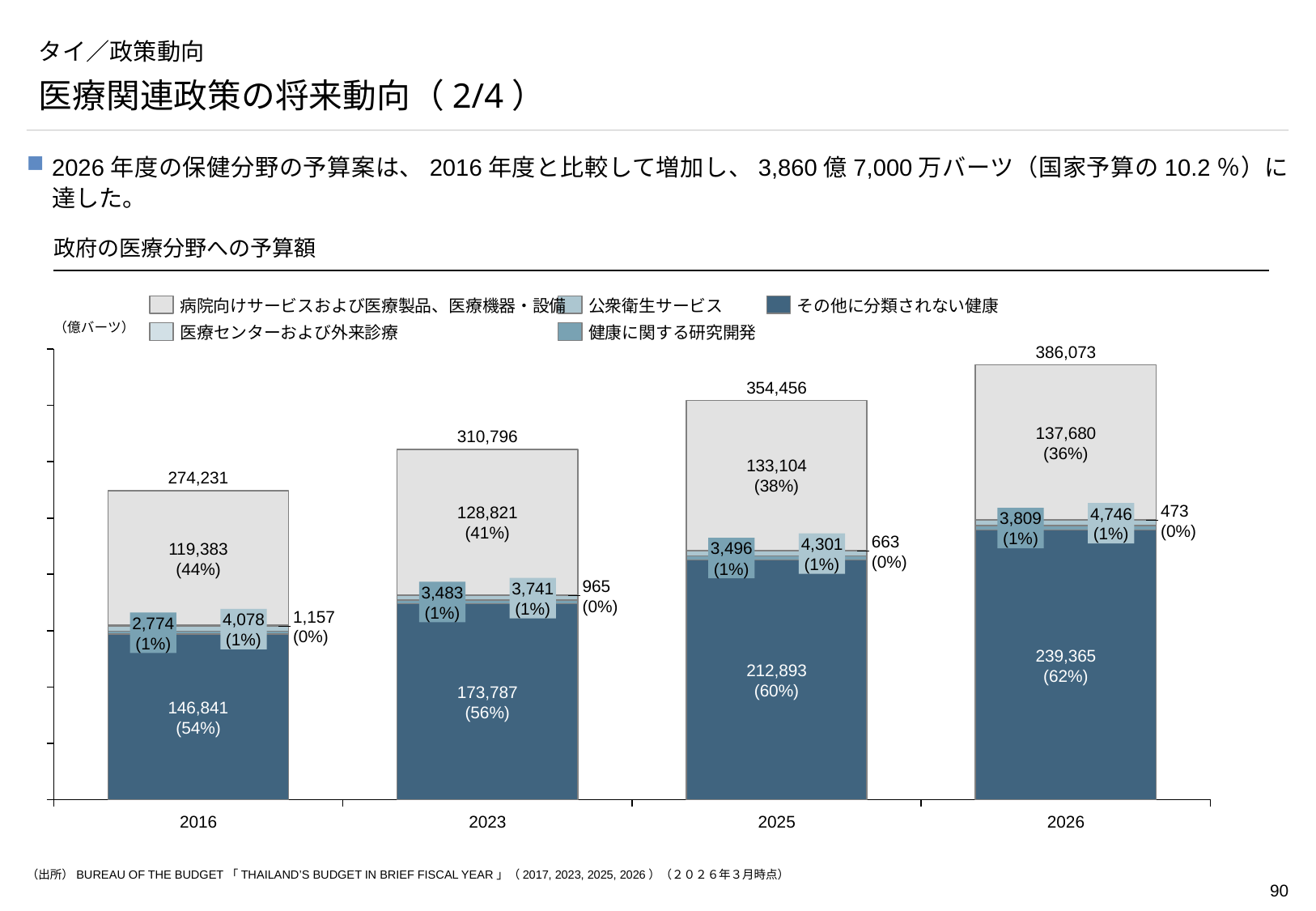
What is the total budget shown above the 2026 bar? 386,073 Do the total budget values rise or fall from 2016 to 2026? rise Which year has the highest total budget? 2026 How many years (categories) are shown on the x axis of the chart? 4 What is the value of その他に分類されない健康 in 2025? 212,893 What is the value of 病院向けサービスおよび医療製品、医療機器・設備 in 2023? 128,821 Which year has the lowest total budget? 2016 How many series does the chart's legend list? 5 What is the total budget shown above the 2016 bar? 274,231 What kind of chart is shown on the slide? stacked bar chart What is the difference between the total budget in 2026 and in 2016? 111,842 What percentage share of the 2026 total does その他に分類されない健康 account for? 62%